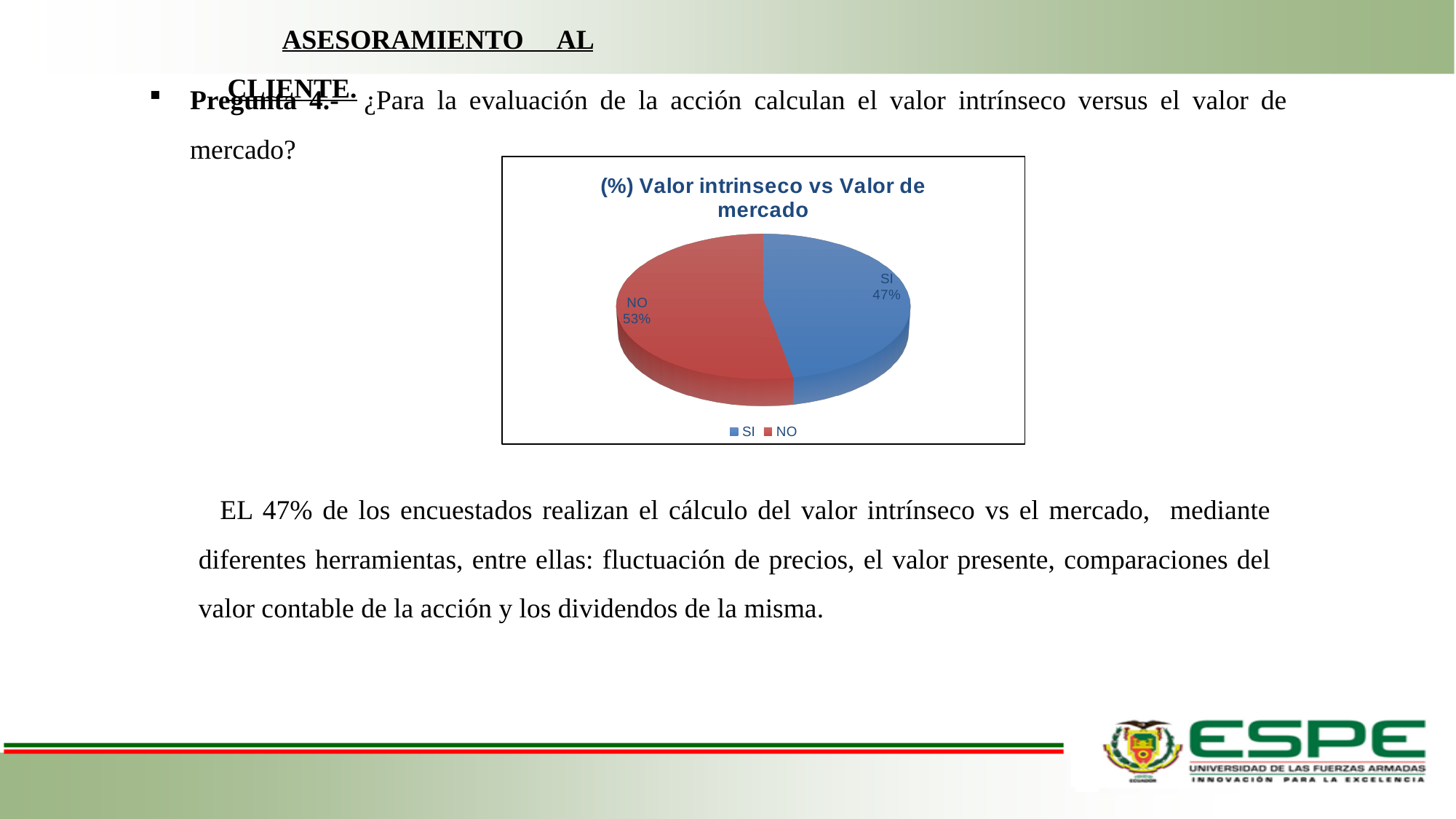
What percentage of the pie corresponds to NO? 53% What percentage of the pie corresponds to SI? 47% How many entries does the legend list? 2 Which is larger, the share for SI or the share for NO? NO What is the title of the chart? (%) Valor intrinseco vs Valor de mercado Which category has the largest share of the pie? NO Is the share for SI greater or less than 50%? less What kind of chart is shown on the slide? pie chart What is the difference in percentage points between NO and SI? 6 How many slices does the pie chart have? 2 What colour is the SI slice? blue Which category has the smallest share of the pie? SI